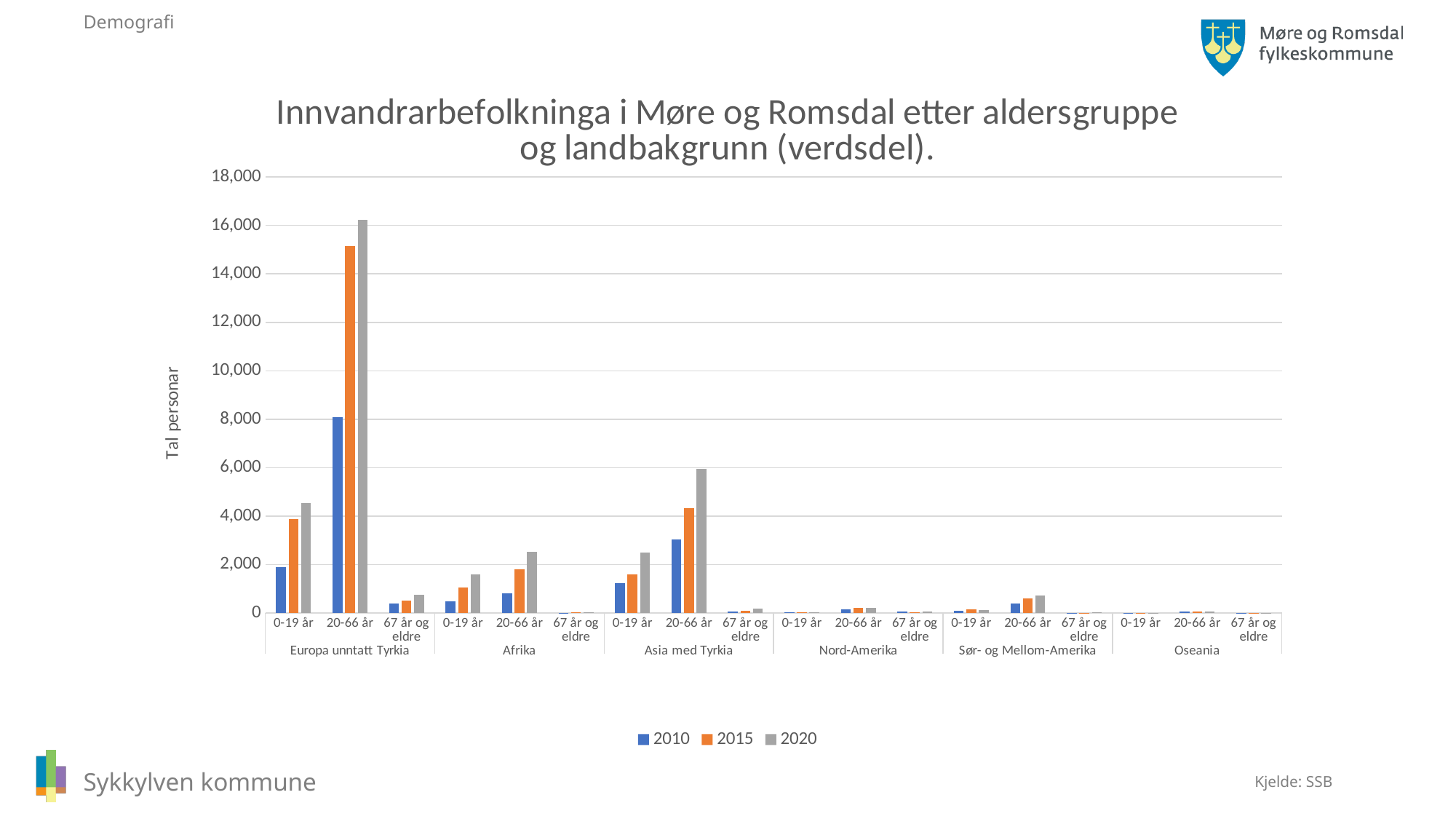
How many series does the legend list? 3 Which region has the lowest bars overall? Oseania Is the 2020 value for 20-66 år in Asia med Tyrkia greater or less than 4,000? greater What is the title of the chart? Innvandrarbefolkninga i Møre og Romsdal etter aldersgruppe og landbakgrunn (verdsdel). For 20-66 år in Europa unntatt Tyrkia, do the values rise or fall from 2010 to 2020? rise Is the 2015 value for 20-66 år in Europa unntatt Tyrkia greater or less than 14,000? greater For 20-66 år in Asia med Tyrkia, which is larger: the 2020 value or the 2020 value for 20-66 år in Afrika? Asia med Tyrkia What are the series names listed in the legend? 2010, 2015, 2020 What kind of chart is shown on the slide? Bar chart Is the 2010 value for 20-66 år in Europa unntatt Tyrkia greater or less than 10,000? less Which region and age group has the highest 2020 bar? 20-66 år, Europa unntatt Tyrkia How many world regions (verdsdel) are shown along the x axis? 6